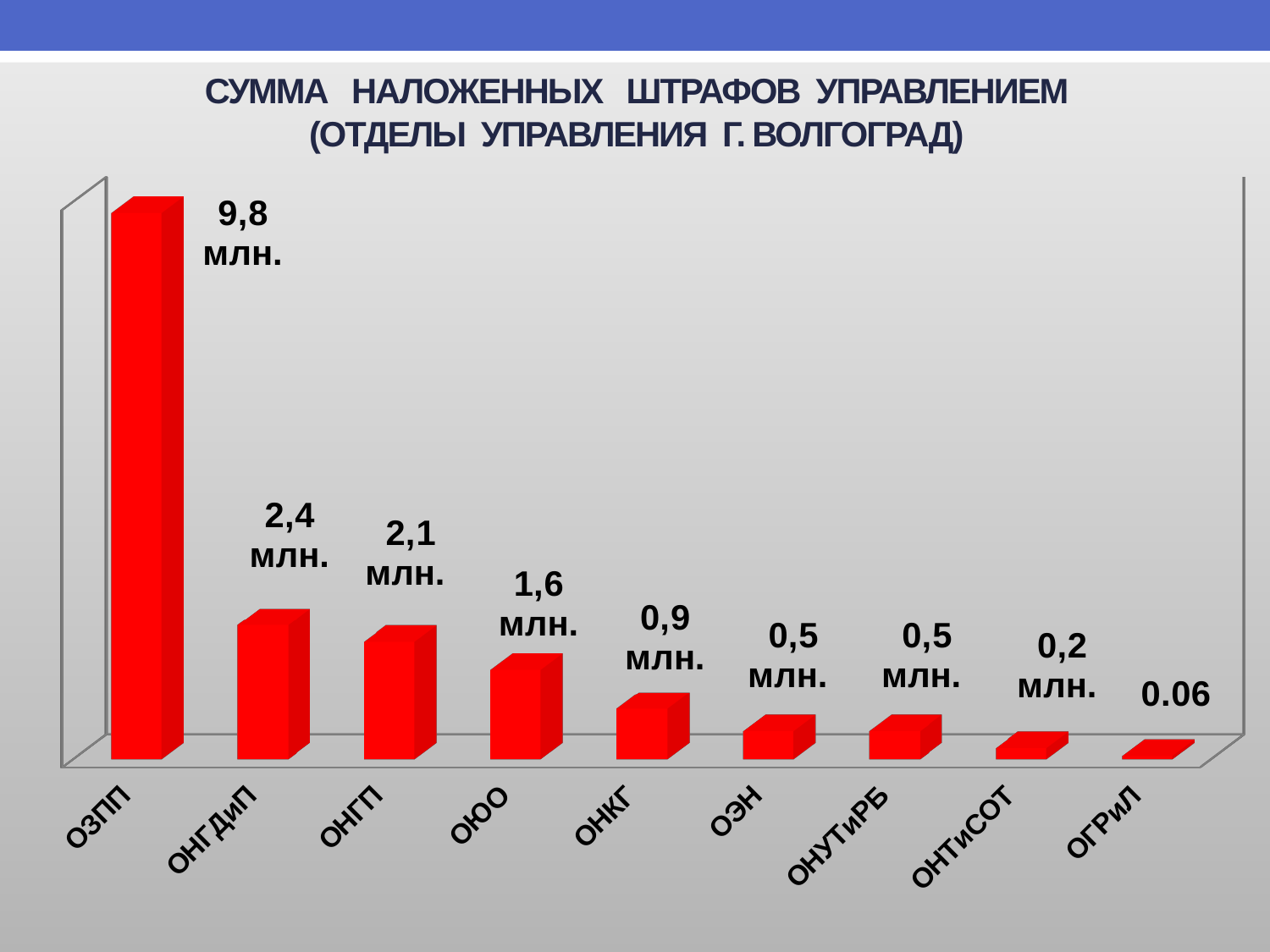
What kind of chart is shown on the slide? Bar chart What is the value shown for ОЗПП? 9,8 млн. What is the difference between the values for ОНГП and ОНКГ? 1,2 млн. What is the value shown for ОГРиЛ? 0.06 How many departments are shown on the chart? 9 Which is larger, the value for ОНГП or the value for ОЮО? ОНГП What is the value shown for ОНГДиП? 2,4 млн. What is the value shown for ОЮО? 1,6 млн. What is the value shown for ОНТиСОТ? 0,2 млн. Which department has the lowest amount of fines? ОГРиЛ Which department has the highest amount of fines? ОЗПП What is the difference between the values for ОЗПП and ОНГДиП? 7,4 млн.